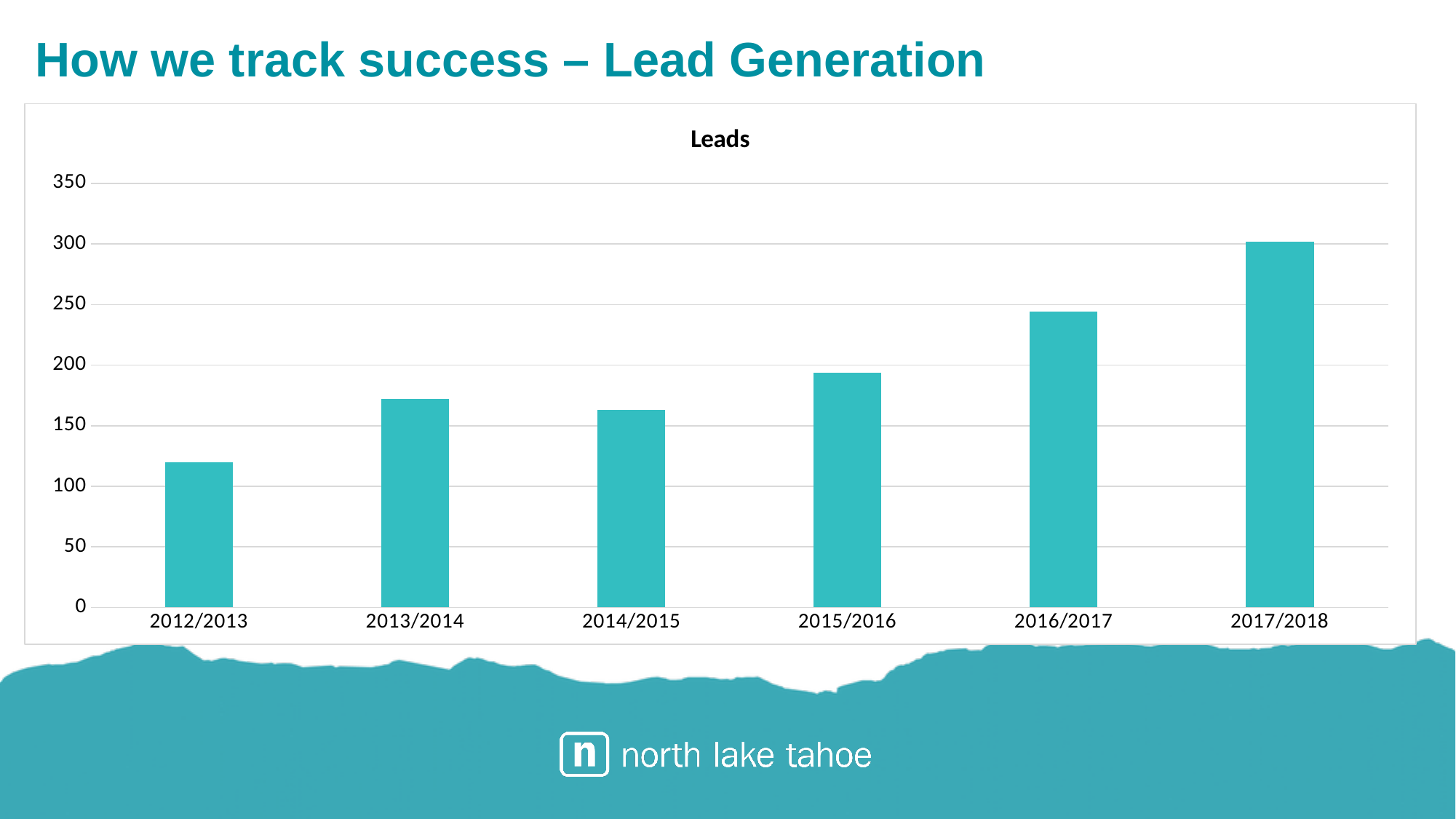
What is the title of the chart? Leads Which is larger, the value for 2013/2014 or the value for 2014/2015? 2013/2014 Do the values generally rise or fall from 2012/2013 to 2017/2018? rise Is the value for 2013/2014 greater or less than 200? less Is the value for 2012/2013 greater or less than 100? greater Which year has the lowest number of leads? 2012/2013 Is the value for 2016/2017 greater or less than 200? greater What kind of chart is shown on the slide? bar chart How many categories (fiscal years) are shown on the x axis? 6 Which year has the highest number of leads? 2017/2018